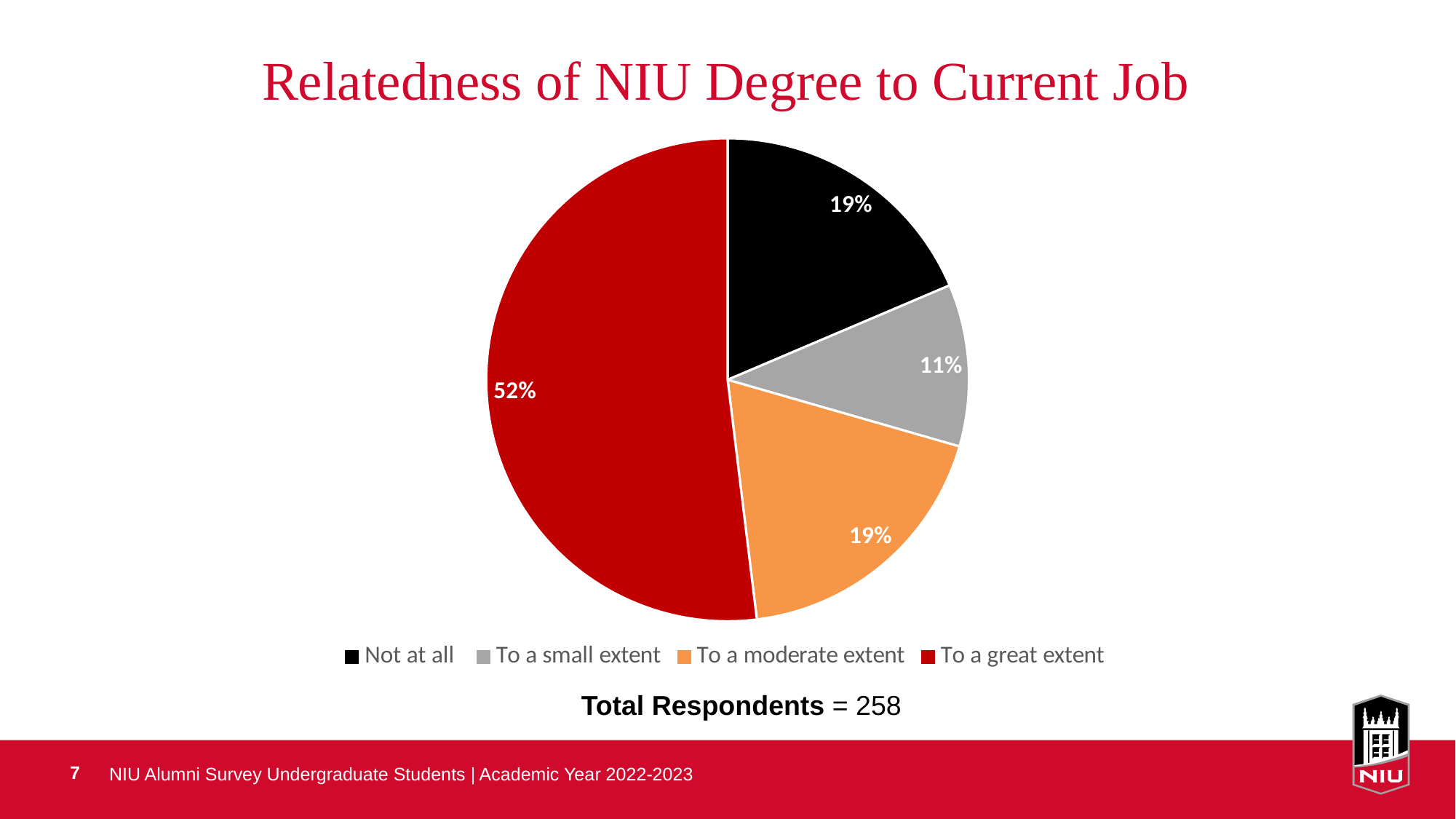
How many categories does the pie chart show? 4 What type of chart is shown on the slide? pie chart What share of respondents answered "Not at all"? 19% What colour is the slice for "To a moderate extent"? orange Which response category has the largest slice of the pie? To a great extent What share of respondents answered "To a great extent"? 52% Which response category has the smallest slice of the pie? To a small extent What share of respondents answered "To a small extent"? 11% What share of respondents answered "To a moderate extent"? 19% What is the difference in percentage points between "To a great extent" and "To a small extent"? 41 What is the total number of respondents stated below the chart? 258 Which is larger: the share for "To a great extent" or the share for "Not at all"? To a great extent